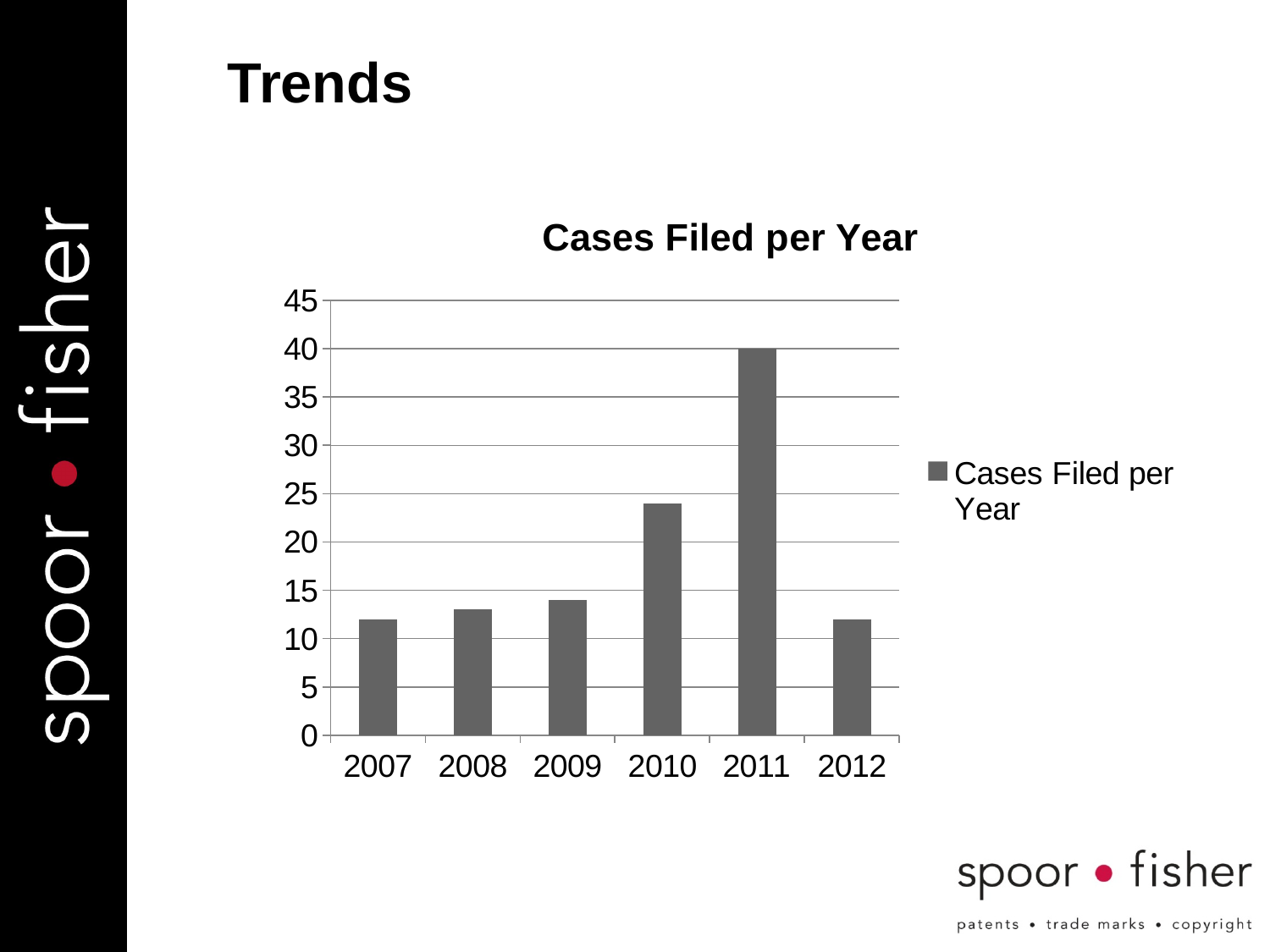
From 2007 to 2011, do the values rise or fall? rise What is the value for 2011 in the Cases Filed per Year chart? 40 Is the value for 2007 greater or less than 10? greater How many years are shown on the x axis of the chart? 6 Is the value for 2010 greater or less than 20? greater What type of chart is shown on the slide? bar chart Which year has more cases filed, 2009 or 2010? 2010 What is the title of the chart? Cases Filed per Year Which year has the highest number of cases filed? 2011 Is the value for 2009 greater or less than 15? less How many series does the legend list? 1